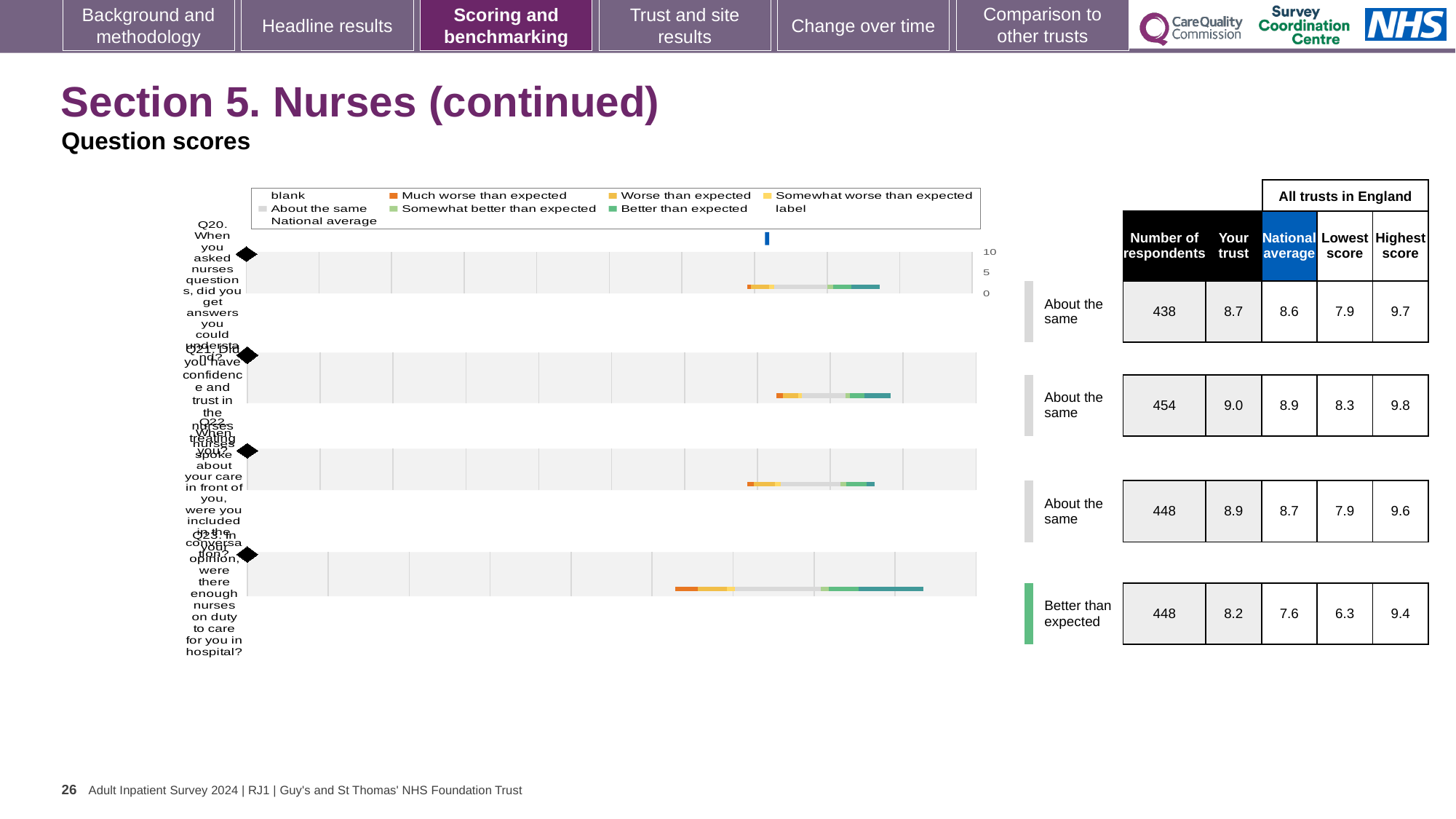
Which legend entry is shown in dark orange? Much worse than expected What is the difference between the 'Your trust' score and the national average for Q23? 0.6 What kind of chart is used to show the question scores on this slide? bar chart Which question has the highest 'Your trust' score? Q21 How many questions (bars) are plotted in the chart? 4 How many respondents answered Q20? 438 What is the highest score across all trusts in England for Q22? 9.6 Which question is rated 'Better than expected' rather than 'About the same'? Q23 What is the highest tick value shown on the chart's score axis? 10 What is the 'Your trust' score for Q21 (confidence and trust in the nurses)? 9.0 What is the national average score for Q23 (enough nurses on duty)? 7.6 Which question has the lowest 'Your trust' score? Q23